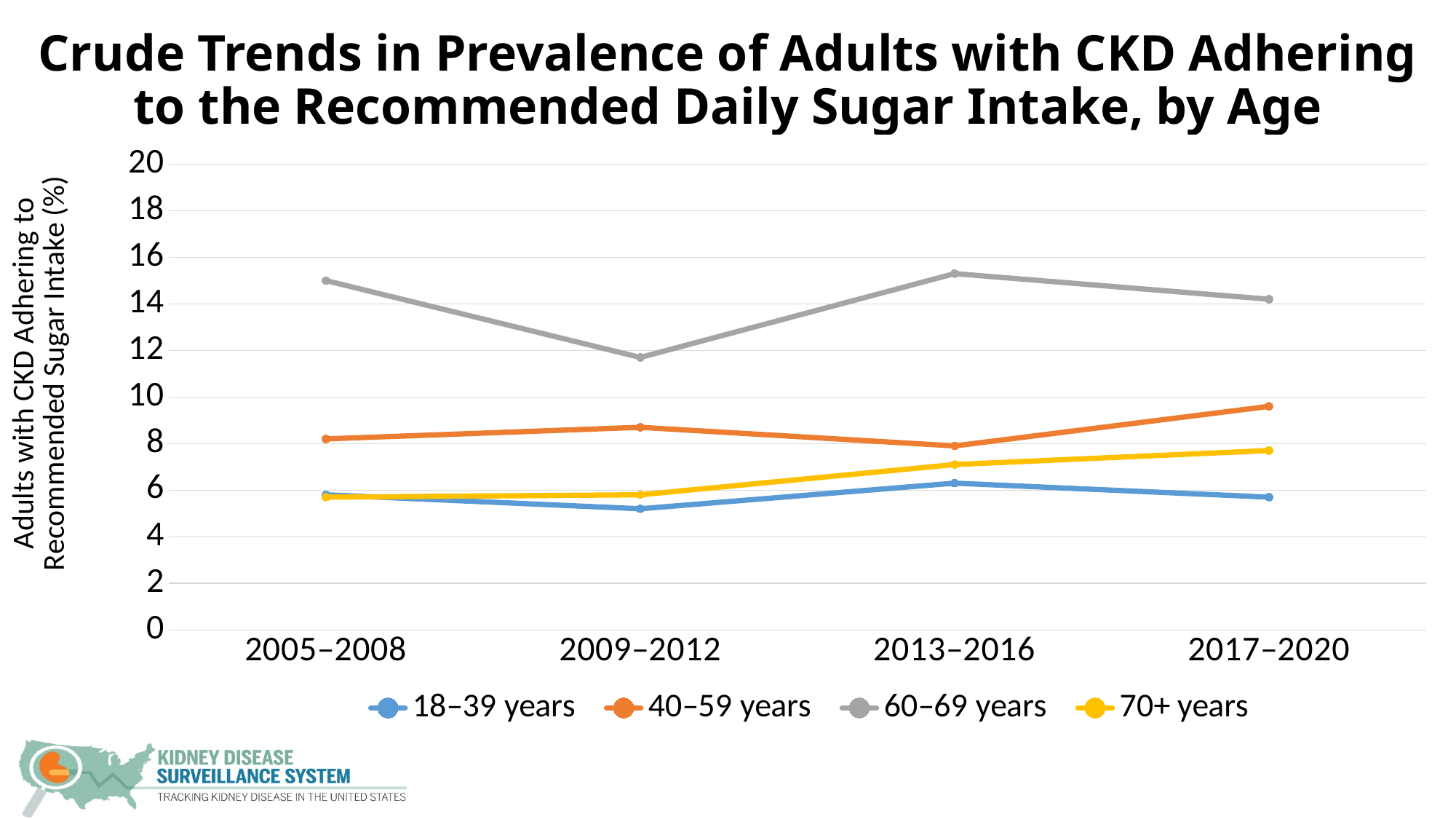
In 2017–2020, which is larger: the value for 40–59 years or the value for 70+ years? 40–59 years Is the value for 60–69 years in 2005–2008 greater or less than 14? greater Does the value for 70+ years rise or fall from 2009–2012 to 2017–2020? rise In which period is the value for 60–69 years lowest? 2009–2012 Which age group has the highest prevalence in 2013–2016? 60–69 years Is the value for 18–39 years in 2009–2012 greater or less than 6? less Which age group has the lowest prevalence in 2009–2012? 18–39 years Is the value for 60–69 years in 2009–2012 greater or less than 14? less How many time periods are shown on the x axis? 4 How many series does the legend list? 4 What kind of chart is shown on the slide? line chart